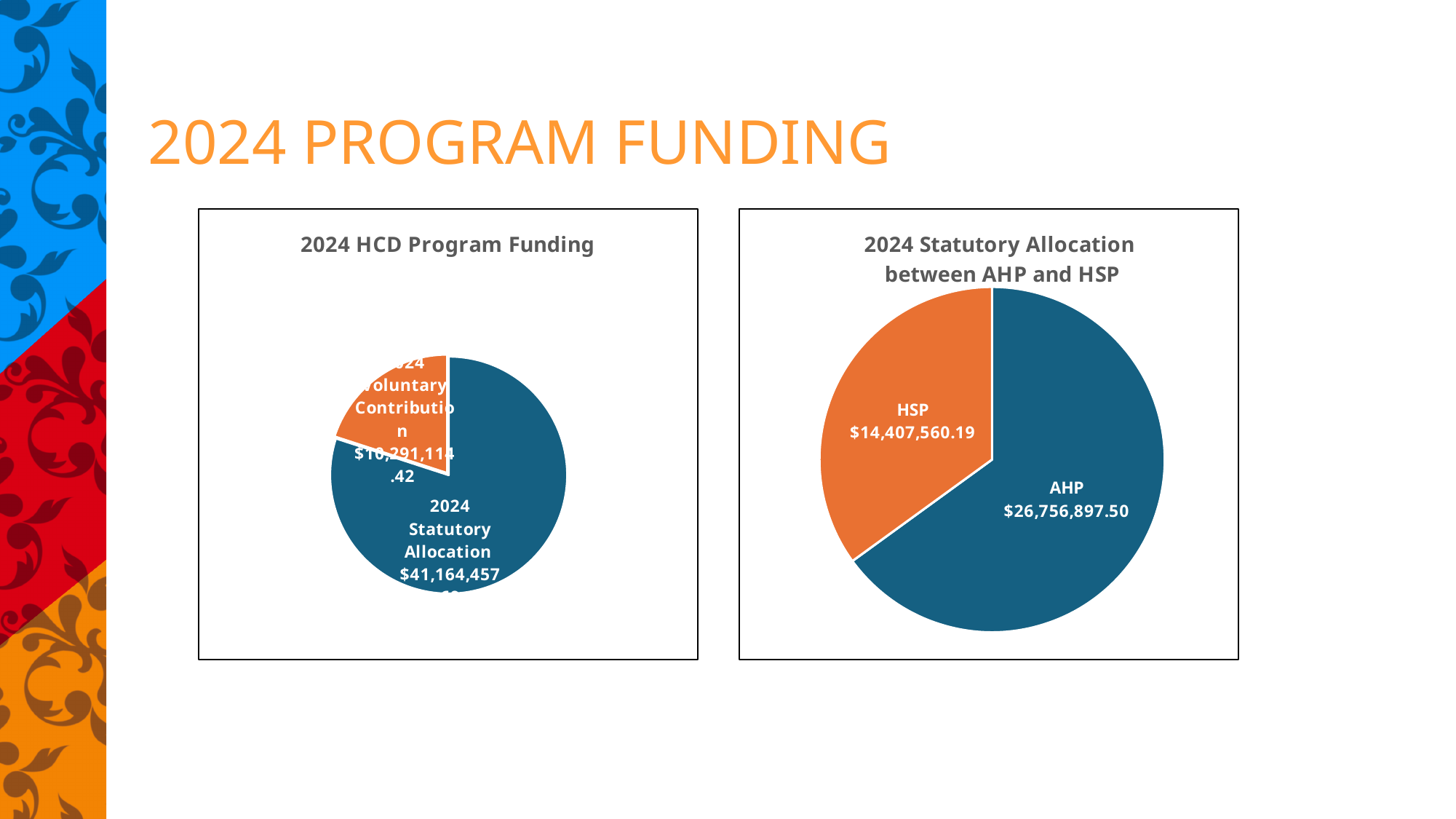
In the "2024 Statutory Allocation between AHP and HSP" chart, which slice is the largest? AHP What kind of chart is the "2024 HCD Program Funding" chart on the left? pie chart In the "2024 HCD Program Funding" chart, which slice is the largest? 2024 Statutory Allocation In the "2024 Statutory Allocation between AHP and HSP" chart, which is larger, AHP or HSP? AHP In the "2024 Statutory Allocation between AHP and HSP" chart, what share of the total does AHP represent? 65% In the "2024 Statutory Allocation between AHP and HSP" chart, what is the difference between the AHP and HSP values? $12,349,337.31 In the "2024 Statutory Allocation between AHP and HSP" chart, what is the total of the AHP and HSP values? $41,164,457.69 In the "2024 Statutory Allocation between AHP and HSP" chart, what is the value for HSP? $14,407,560.19 In the "2024 Statutory Allocation between AHP and HSP" chart, what is the value for AHP? $26,756,897.50 What kind of chart is the "2024 Statutory Allocation between AHP and HSP" chart on the right? pie chart In the "2024 HCD Program Funding" chart, what is the value for 2024 Voluntary Contribution? $10,291,114.42 How many slices does the "2024 Statutory Allocation between AHP and HSP" chart have? 2